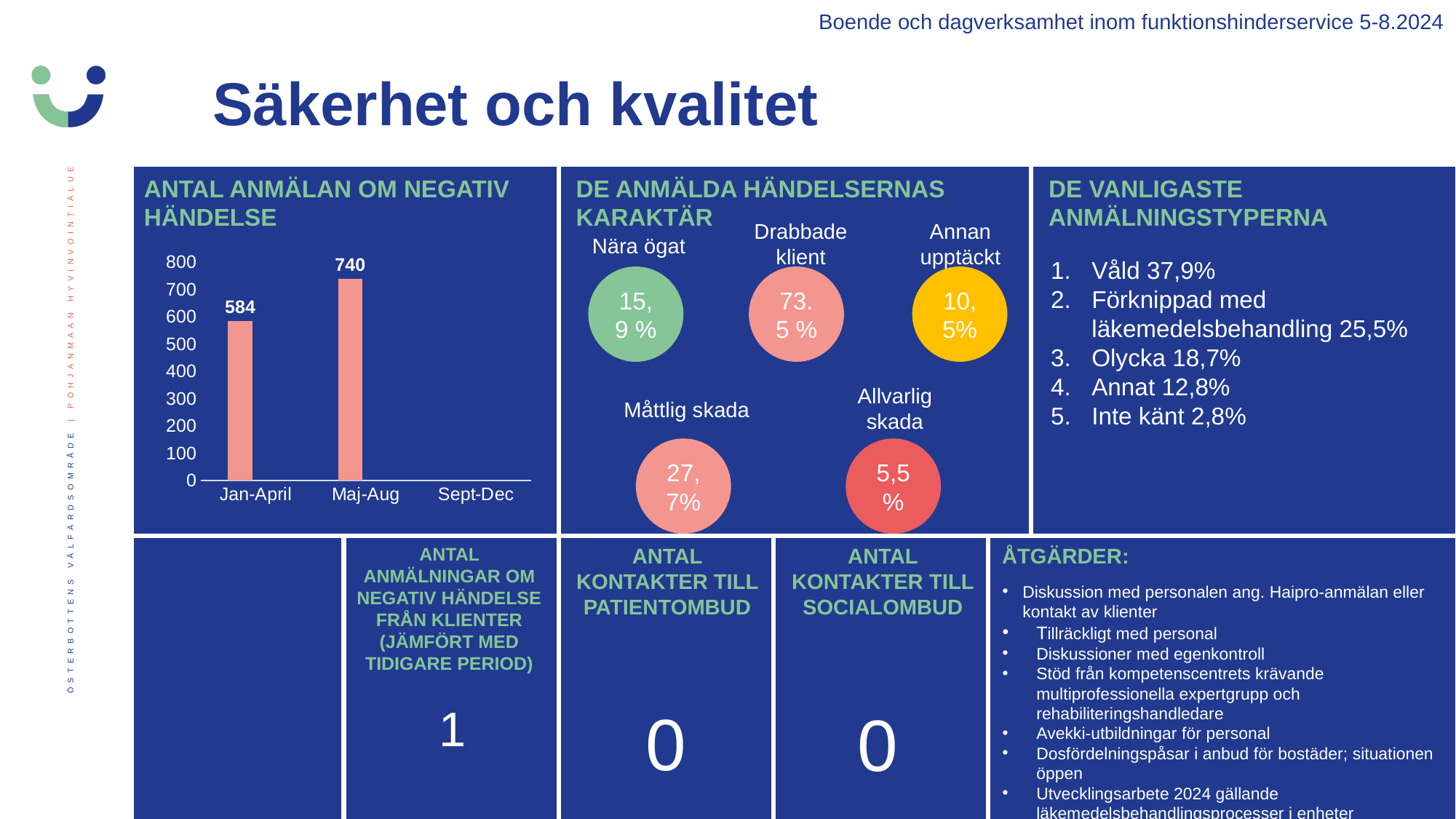
What is the highest value shown on the y axis of the chart 'ANTAL ANMÄLAN OM NEGATIV HÄNDELSE'? 800 In the chart 'ANTAL ANMÄLAN OM NEGATIV HÄNDELSE', is the value for Maj-Aug greater or less than 700? greater In the chart 'ANTAL ANMÄLAN OM NEGATIV HÄNDELSE', what is the difference between the Maj-Aug and Jan-April values? 156 In the chart 'ANTAL ANMÄLAN OM NEGATIV HÄNDELSE', what is the value for Jan-April? 584 In the chart 'ANTAL ANMÄLAN OM NEGATIV HÄNDELSE', which period has the highest value? Maj-Aug How many period labels are shown on the x axis of the chart 'ANTAL ANMÄLAN OM NEGATIV HÄNDELSE'? 3 In the chart 'ANTAL ANMÄLAN OM NEGATIV HÄNDELSE', is the value for Jan-April greater or less than 600? less In the chart 'ANTAL ANMÄLAN OM NEGATIV HÄNDELSE', do the values rise or fall from Jan-April to Maj-Aug? rise In the chart 'ANTAL ANMÄLAN OM NEGATIV HÄNDELSE', what is the value for Maj-Aug? 740 What kind of chart is 'ANTAL ANMÄLAN OM NEGATIV HÄNDELSE'? bar chart In the chart 'ANTAL ANMÄLAN OM NEGATIV HÄNDELSE', which of the plotted bars has the lowest value? Jan-April In the chart 'ANTAL ANMÄLAN OM NEGATIV HÄNDELSE', which is larger, Jan-April or Maj-Aug? Maj-Aug